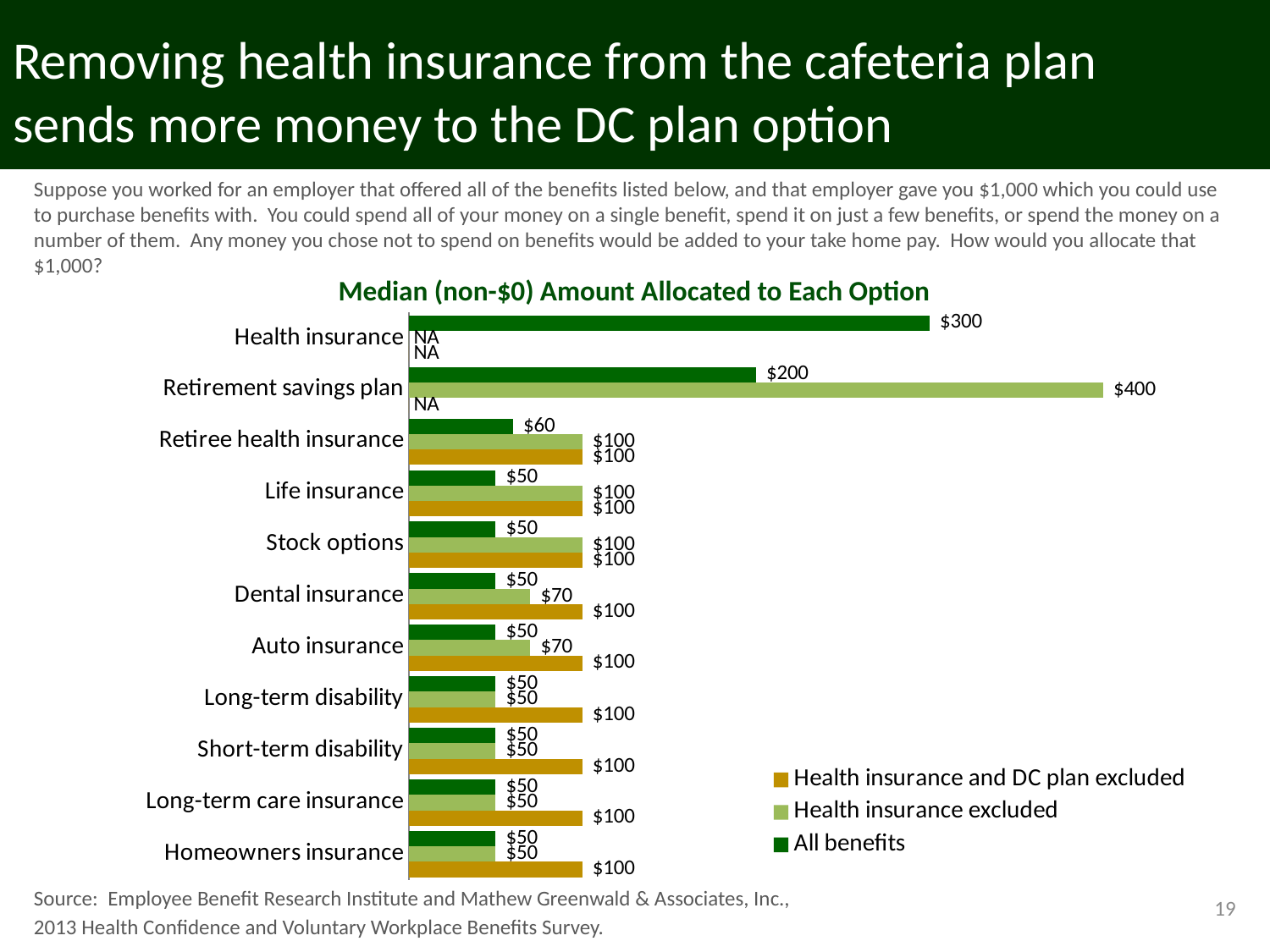
For Retiree health insurance, what is the difference between the Health insurance excluded value and the All benefits value? $40 For Dental insurance, which is larger: the Health insurance excluded value or the Health insurance and DC plan excluded value? Health insurance and DC plan excluded Which category has the highest value in the All benefits series? Health insurance What is the Health insurance excluded value for Dental insurance? $70 What is the median amount allocated to the Retirement savings plan when health insurance is excluded? $400 What type of chart is shown on the slide? Bar chart For the Retirement savings plan, how much larger is the Health insurance excluded value than the All benefits value? $200 How many benefit categories are shown on the chart? 11 What is the All benefits value for Retiree health insurance? $60 What is the Health insurance and DC plan excluded value for Homeowners insurance? $100 What is the median amount allocated to Health insurance in the All benefits series? $300 How many series does the legend list? 3